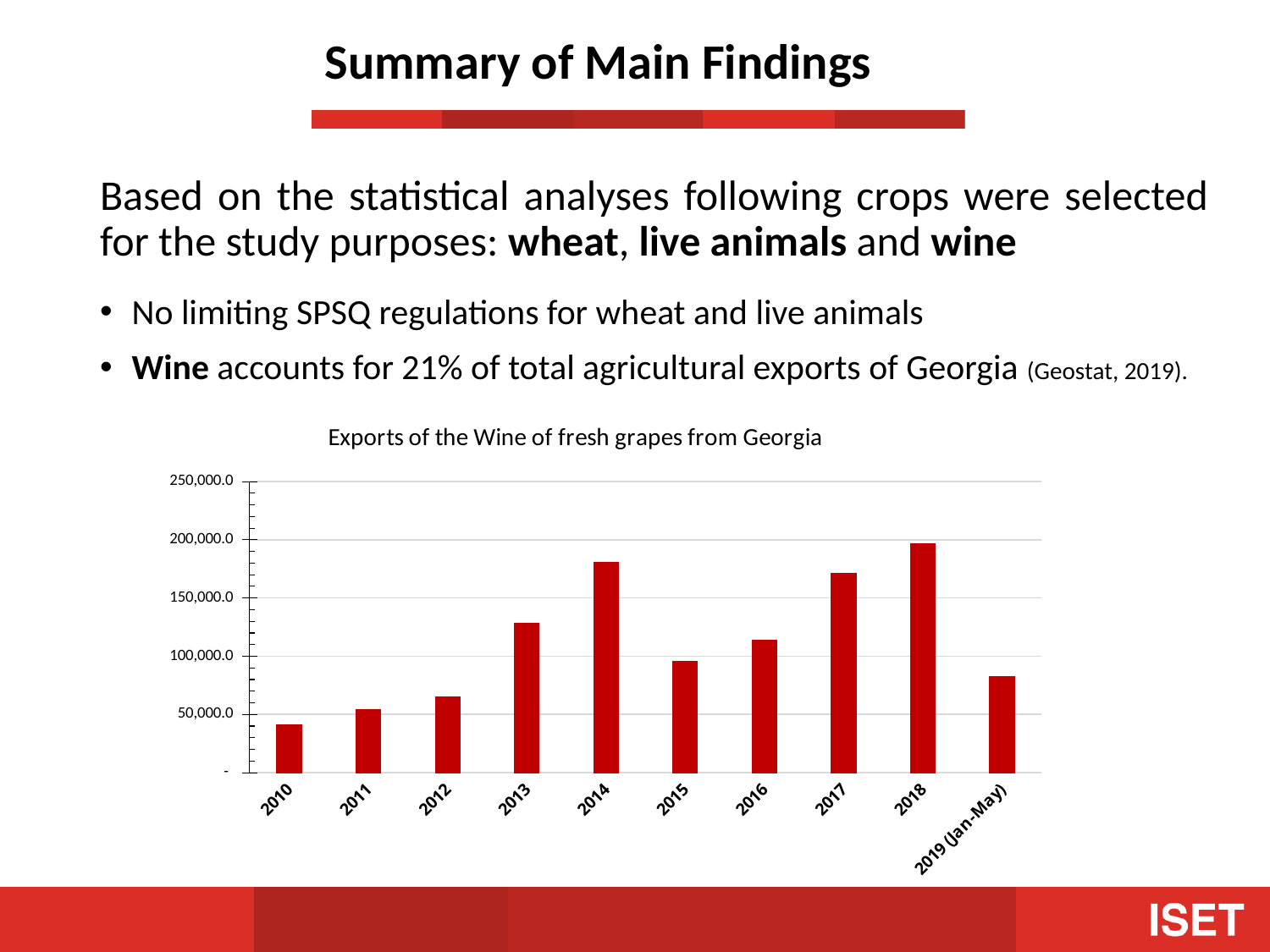
What kind of chart is shown on the slide? bar chart Do the values rise or fall from 2010 to 2014? rise Which is larger, the value for 2014 or the value for 2015? 2014 What is the title of the chart? Exports of the Wine of fresh grapes from Georgia Which year has the lowest value in the chart? 2010 How many categories (years) are shown on the x axis of the chart? 10 Is the value for 2013 greater or less than 100,000.0? greater Is the value for 2015 greater or less than 100,000.0? less Is the value for 2014 greater or less than 150,000.0? greater Which year has the highest value in the chart? 2018